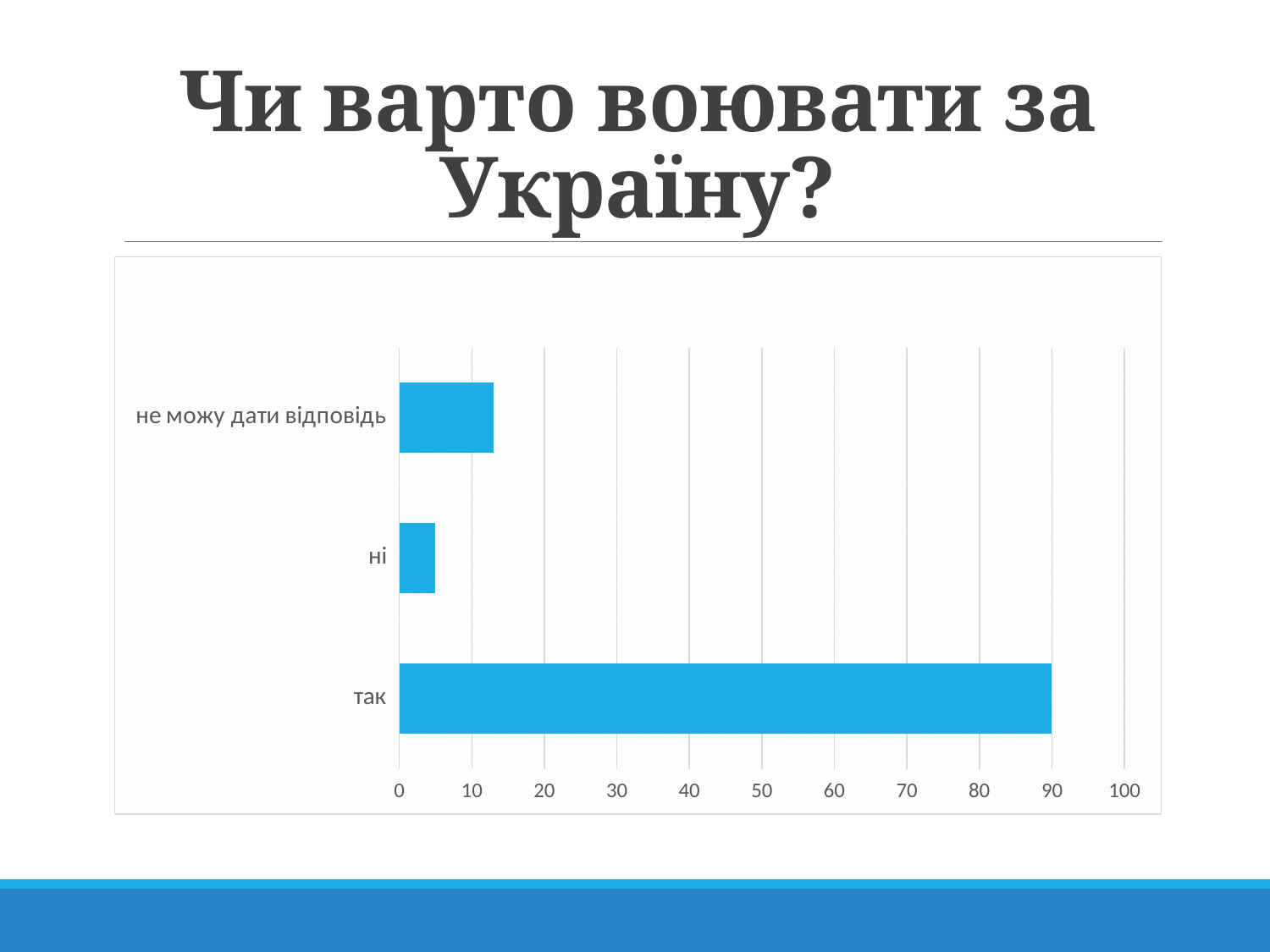
Is the value for "не можу дати відповідь" greater or less than 10? greater What is the value for "так"? 90 Is the value for "так" greater or less than 80? greater What kind of chart is shown on the slide? bar chart How many categories are shown in the chart? 3 Which is larger, the value for "не можу дати відповідь" or the value for "ні"? не можу дати відповідь Is the value for "не можу дати відповідь" greater or less than 20? less Which category has the lowest value? ні What is the title of the slide above the chart? Чи варто воювати за Україну? What colour are the bars in the chart? blue Which category has the highest value? так